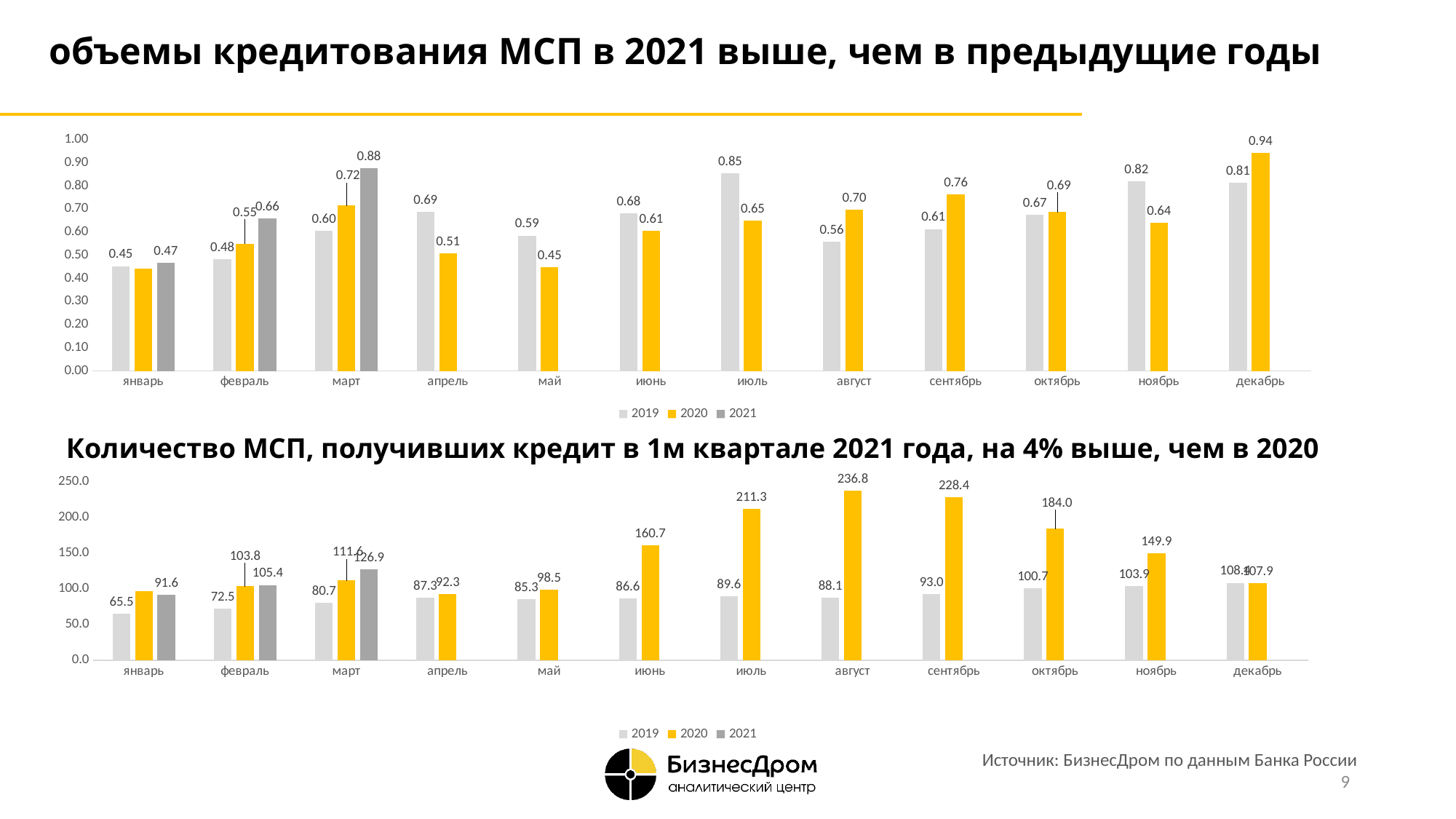
In the bottom chart, what is the difference between the 2021 and 2019 values in март? 46.2 In the top chart, what is the value for 2021 in март? 0.88 In the top chart, which is larger in ноябрь: the 2019 value or the 2020 value? 2019 In the top chart, what is the value for 2020 in декабрь? 0.94 How many series does the legend of the top chart list? 3 In the top chart, what is the difference between the 2020 and 2019 values in сентябрь? 0.15 In the bottom chart, which month has the lowest value for the 2019 series? январь In the bottom chart, what is the value for 2020 in август? 236.8 How many months are shown on the x axis of the bottom chart? 12 In the top chart, is the 2020 value for январь greater or less than 0.50? less What type of chart is the bottom chart? bar chart In the top chart, which month has the highest value for the 2019 series? июль